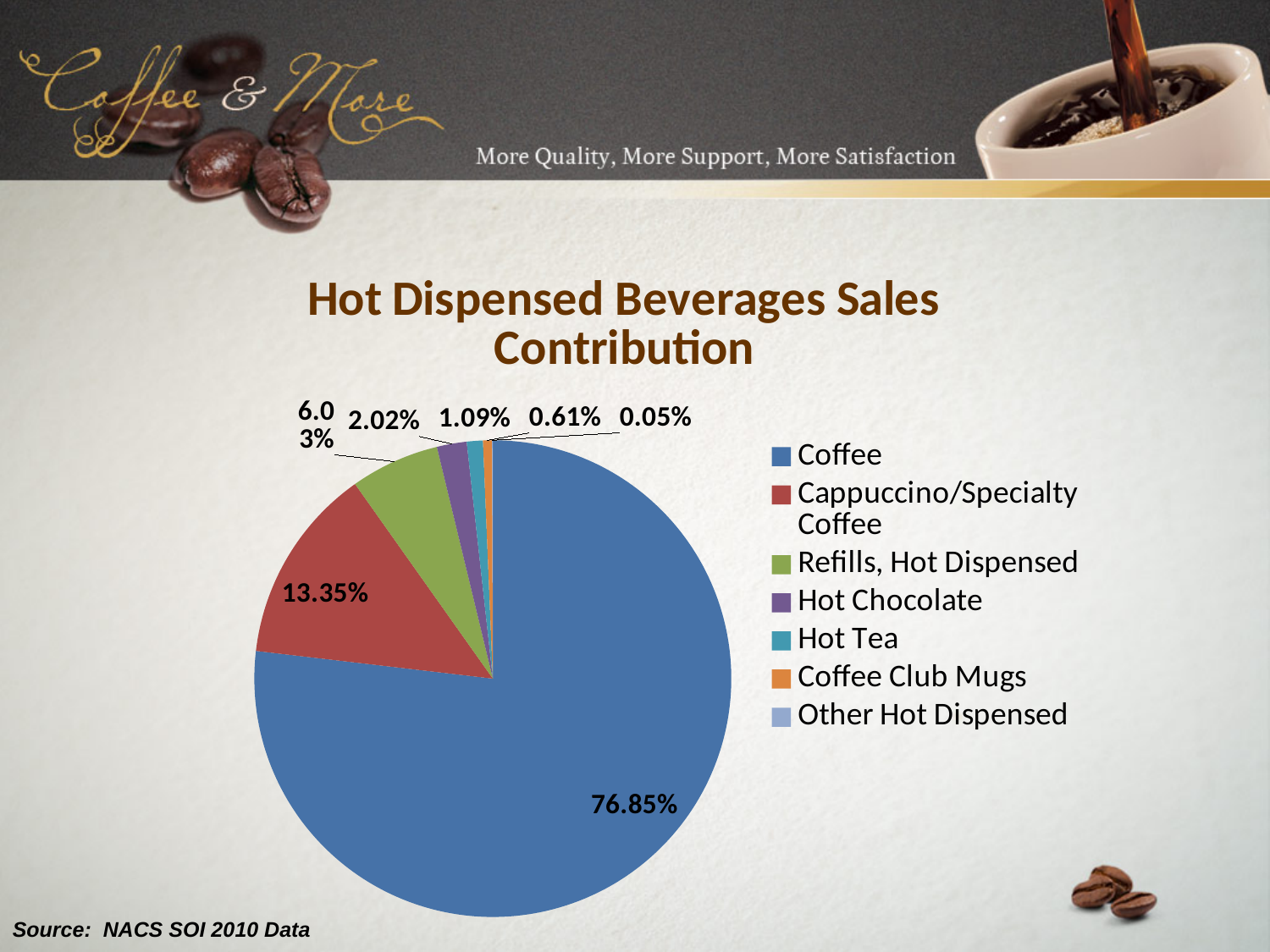
Which category has the largest share of the pie? Coffee What is the difference between the Coffee share and the Cappuccino/Specialty Coffee share? 63.50% Which contributes a larger share, Cappuccino/Specialty Coffee or Refills, Hot Dispensed? Cappuccino/Specialty Coffee What is the title of the chart? Hot Dispensed Beverages Sales Contribution How many categories does the legend list? 7 What share of sales does Cappuccino/Specialty Coffee contribute? 13.35% Which category has the smallest share of the pie? Other Hot Dispensed What type of chart is shown on the slide? pie chart What share of sales does Hot Chocolate contribute? 2.02% What share of hot dispensed beverage sales does Coffee contribute? 76.85% What share of sales does Hot Tea contribute? 1.09% What share of sales does Coffee Club Mugs contribute? 0.61%